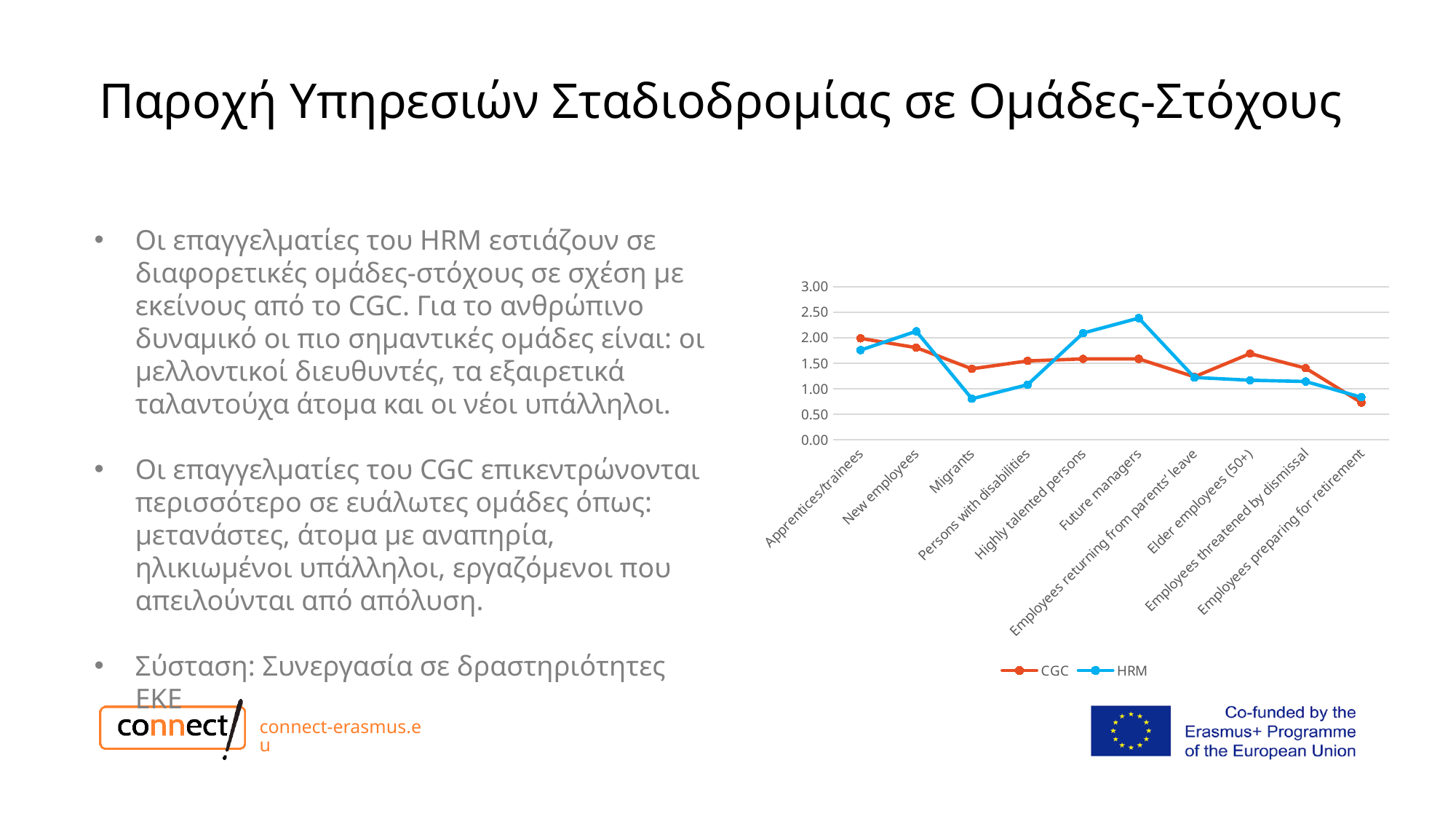
How many series does the chart legend list? 2 Is the HRM value for Future managers greater or less than 2.00? greater For Migrants, which series has the larger value, CGC or HRM? CGC How many target-group categories are plotted along the x axis? 10 Which category has the highest CGC value? Apprentices/trainees Is the HRM value for Migrants greater or less than 1.00? less Which category has the highest HRM value? Future managers Which category has the lowest CGC value? Employees preparing for retirement Does the HRM line rise or fall from Future managers to Employees preparing for retirement? fall For Future managers, which series has the larger value, CGC or HRM? HRM For Elder employees (50+), which series has the larger value, CGC or HRM? CGC What kind of chart is shown on the slide? line chart